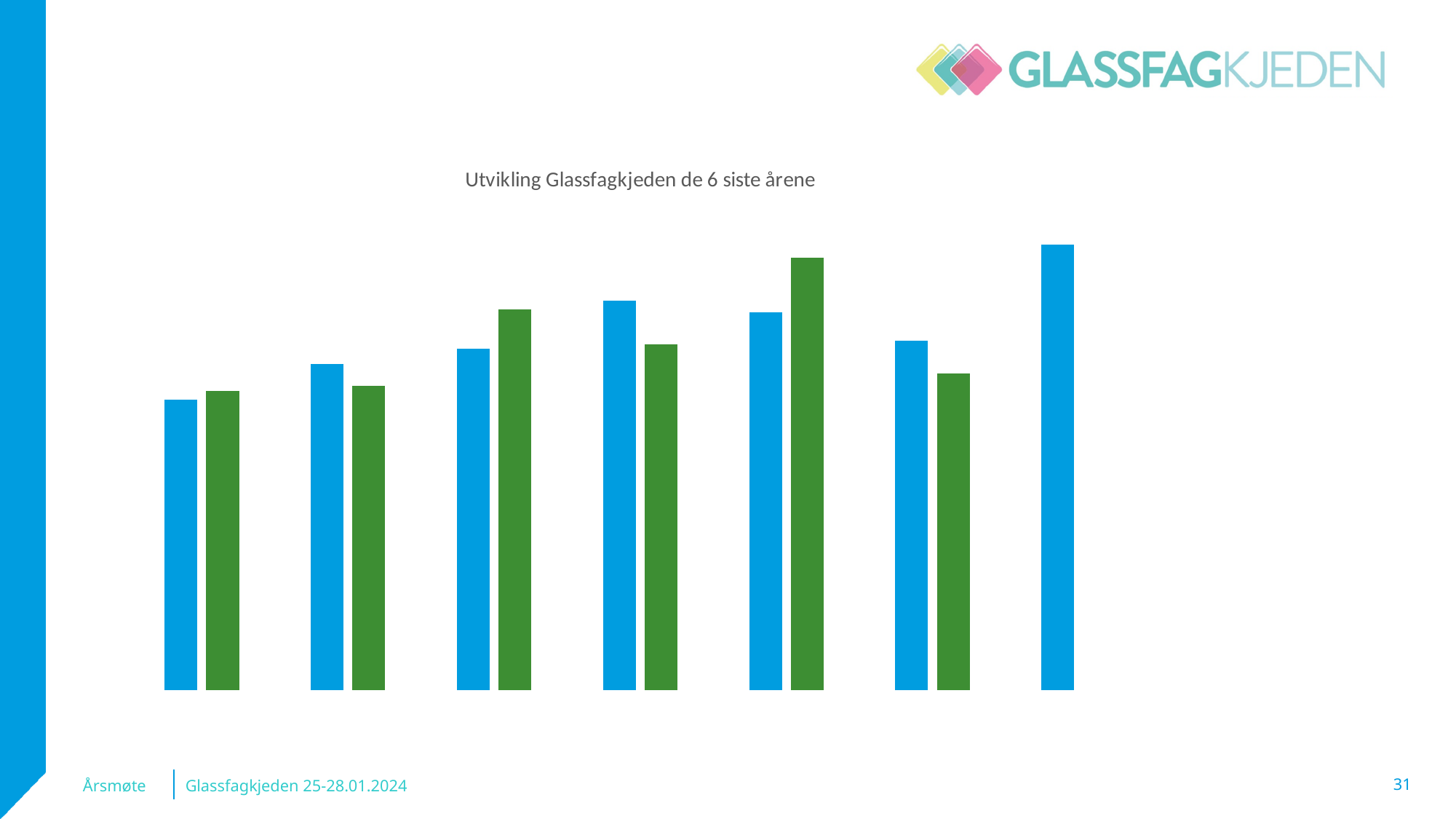
What two colours are used for the bars in the chart? Blue and green In the third pair of bars from the left, which bar is taller, the blue or the green? Green What is the title of the chart? Utvikling Glassfagkjeden de 6 siste årene How many bars are plotted in the chart in total? 13 Do the blue bars rise or fall from the first group to the fourth group? Rise How many blue bars are plotted in the chart? 7 Which blue bar is the tallest in the chart? The rightmost (seventh) blue bar What kind of chart is shown on the slide? Bar chart How many green bars are plotted in the chart? 6 Which green bar is the tallest in the chart? The fifth green bar In the fourth pair of bars from the left, which bar is taller, the blue or the green? Blue Which blue bar is the shortest in the chart? The leftmost (first) blue bar